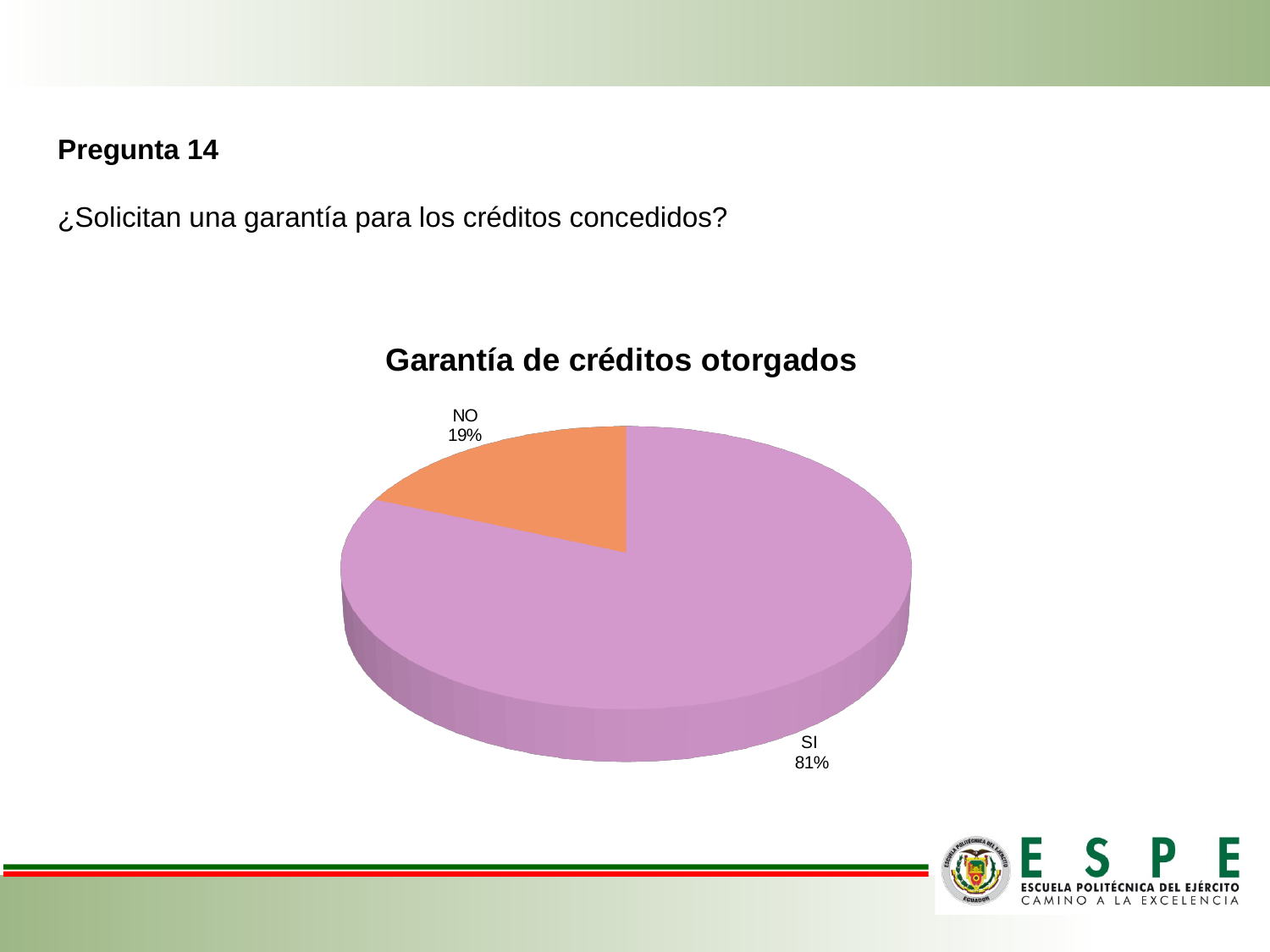
What type of chart is shown on the slide? Pie chart Which is larger, the SI slice or the NO slice? SI What percentage of the pie does the NO slice represent? 19% What is the difference in percentage points between the SI and NO slices? 62 Which slice is the largest in the pie chart? SI What percentage of the pie does the SI slice represent? 81% What is the title of the chart? Garantía de créditos otorgados How many slices does the pie chart have? 2 What colour is the SI slice? Purple Which slice is the smallest in the pie chart? NO